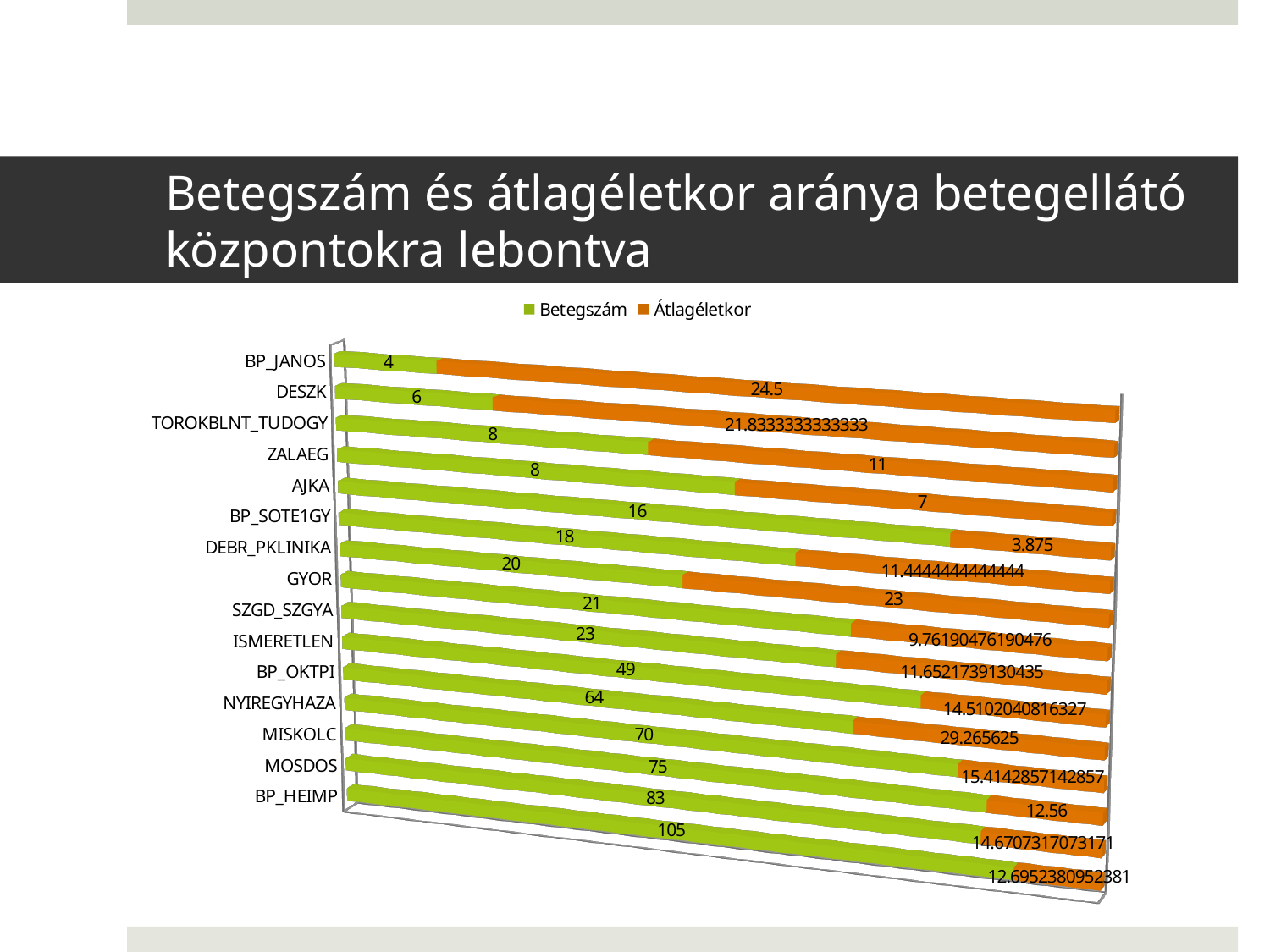
What is the difference in Betegszám between BP_HEIMP and MOSDOS? 22 How many series does the legend list? 2 Which has a larger Betegszám, MISKOLC or NYIREGYHAZA? MISKOLC Which centre has the lowest Betegszám? BP_JANOS How many patient care centres (categories) are shown on the chart? 15 What is the Átlagéletkor value for BP_JANOS? 24.5 What kind of chart is shown on the slide? bar chart What is the Betegszám value for BP_HEIMP? 105 What is the Betegszám value for BP_JANOS? 4 Which centre has the highest Betegszám? BP_HEIMP What is the Betegszám value for MOSDOS? 83 What are the two series named in the legend? Betegszám and Átlagéletkor